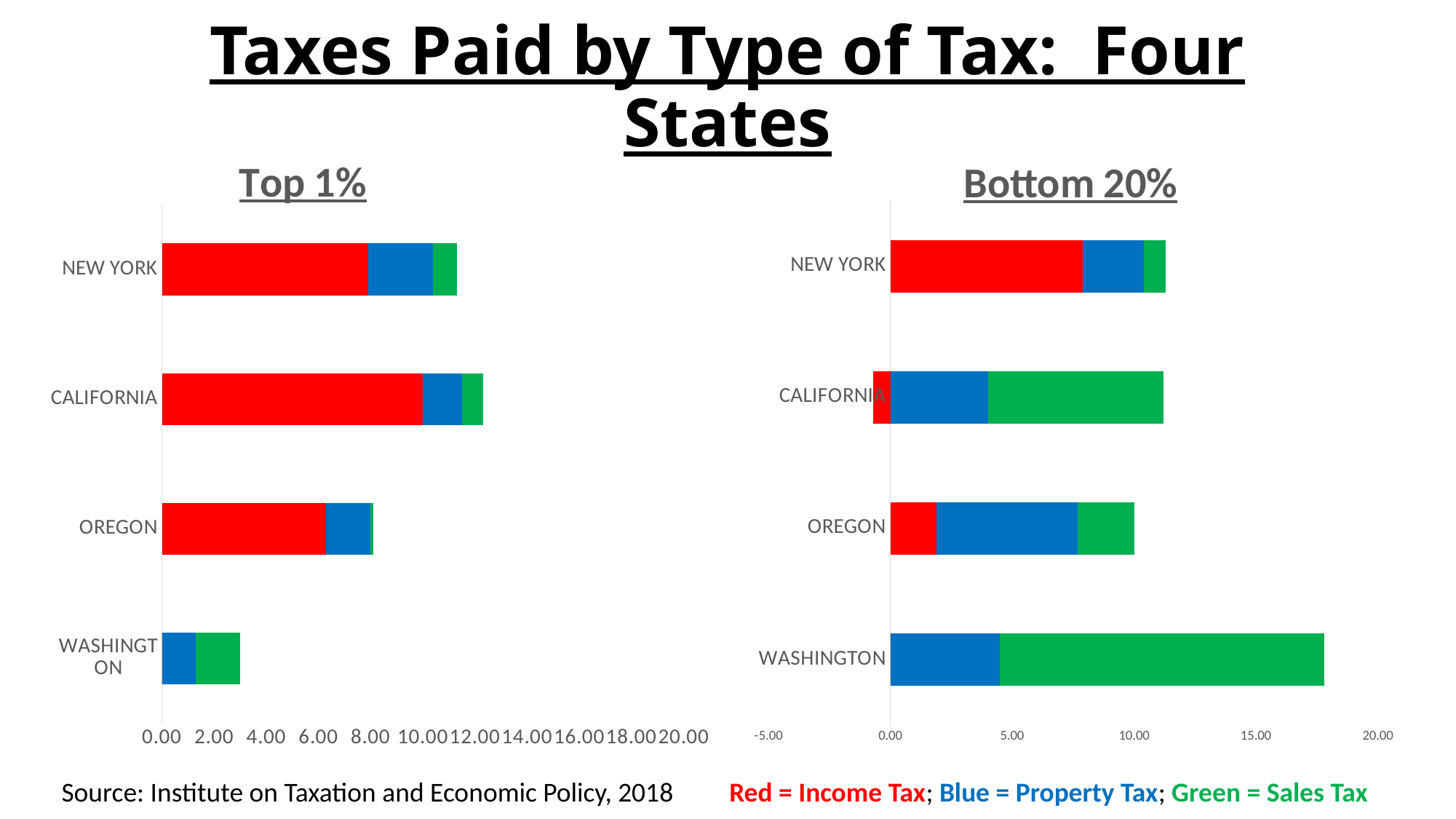
In the Top 1% chart, is the total bar for New York greater or less than 10.00? greater In the Top 1% chart, which state has the longest total bar? California How many states are shown in the Bottom 20% chart? 4 In the Top 1% chart, is the total bar for Washington greater or less than 4.00? less In the Bottom 20% chart, which state has the longest total bar? Washington According to the colour key, which type of tax is shown in green? Sales Tax In the Top 1% chart, which state has the larger total bar, Oregon or Washington? Oregon In the Bottom 20% chart, is the total bar for Oregon greater or less than 15.00? less How many tax types does the colour key at the bottom of the slide list? 3 What kind of chart is the Top 1% chart? Stacked bar chart In the Top 1% chart, which state has the shortest total bar? Washington